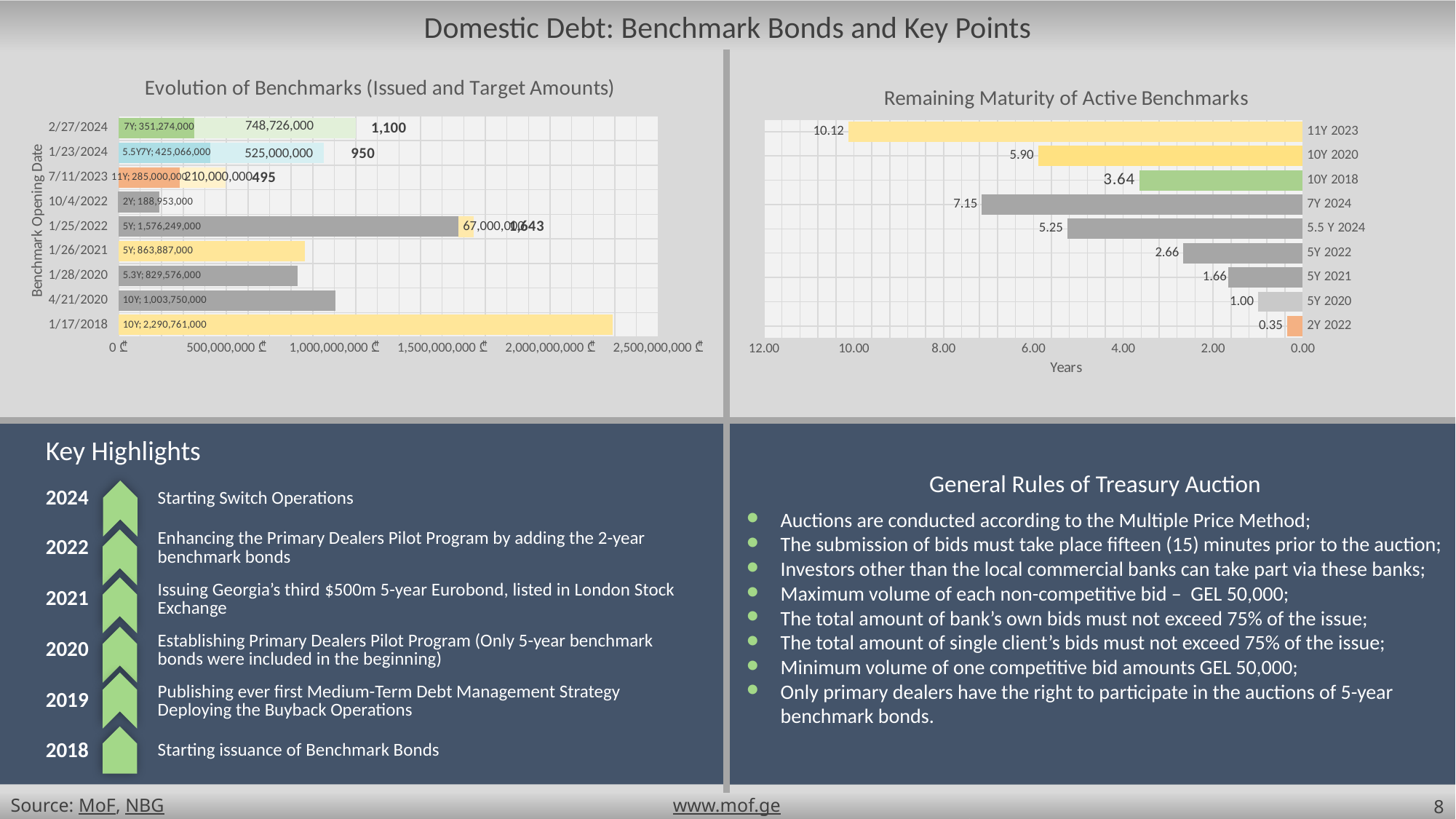
In the Remaining Maturity of Active Benchmarks chart, what is the difference in remaining maturity between the 7Y 2024 and 5.5 Y 2024 benchmarks? 1.90 In the Evolution of Benchmarks chart, is the issued amount for the benchmark opened on 1/26/2021 greater or less than 1,000,000,000 ₾? less How many benchmarks are shown in the Remaining Maturity of Active Benchmarks chart? 9 In the Remaining Maturity of Active Benchmarks chart, which has the longer remaining maturity, 10Y 2020 or 10Y 2018? 10Y 2020 In the Evolution of Benchmarks chart, what is the issued amount for the benchmark opened on 1/17/2018? 2,290,761,000 In the Remaining Maturity of Active Benchmarks chart, which benchmark has the longest remaining maturity? 11Y 2023 In the Evolution of Benchmarks chart, what is the issued amount for the benchmark opened on 10/4/2022? 188,953,000 What type of chart is the Remaining Maturity of Active Benchmarks chart? Bar chart In the Remaining Maturity of Active Benchmarks chart, what is the remaining maturity of the 11Y 2023 benchmark? 10.12 In the Remaining Maturity of Active Benchmarks chart, which benchmark has the shortest remaining maturity? 2Y 2022 What is the x-axis title of the Remaining Maturity of Active Benchmarks chart? Years How many benchmark opening dates are listed in the Evolution of Benchmarks chart? 9